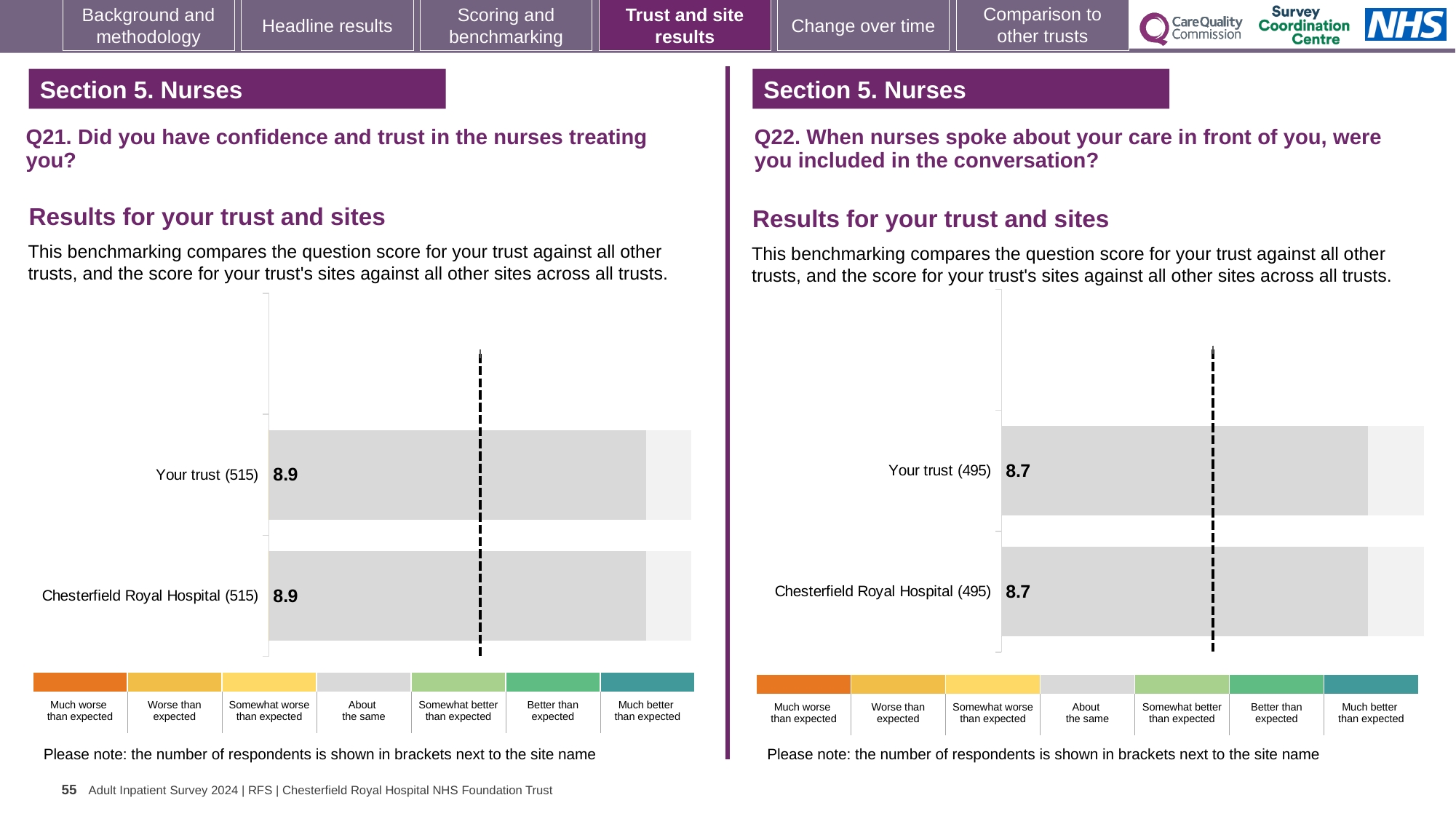
On the Q21 chart (left), what is the score for Chesterfield Royal Hospital? 8.9 On the Q22 chart (right), how many respondents are shown in brackets next to Chesterfield Royal Hospital? 495 On the Q21 chart (left), what is the score for Your trust? 8.9 On the Q22 chart (right), what is the difference between the score for Your trust and the score for Chesterfield Royal Hospital? 0 On the Q21 chart (left), what is the difference between the score for Your trust and the score for Chesterfield Royal Hospital? 0 How many bars are plotted on the Q21 chart (left)? 2 Is the score for Your trust on the Q21 chart (left) larger or smaller than the score for Your trust on the Q22 chart (right)? Larger On the Q22 chart (right), what is the score for Your trust? 8.7 What kind of chart is the Q22 chart (right)? Bar chart On the Q22 chart (right), what is the score for Chesterfield Royal Hospital? 8.7 How many bars are plotted on the Q22 chart (right)? 2 On the Q21 chart (left), how many respondents are shown in brackets next to Your trust? 515